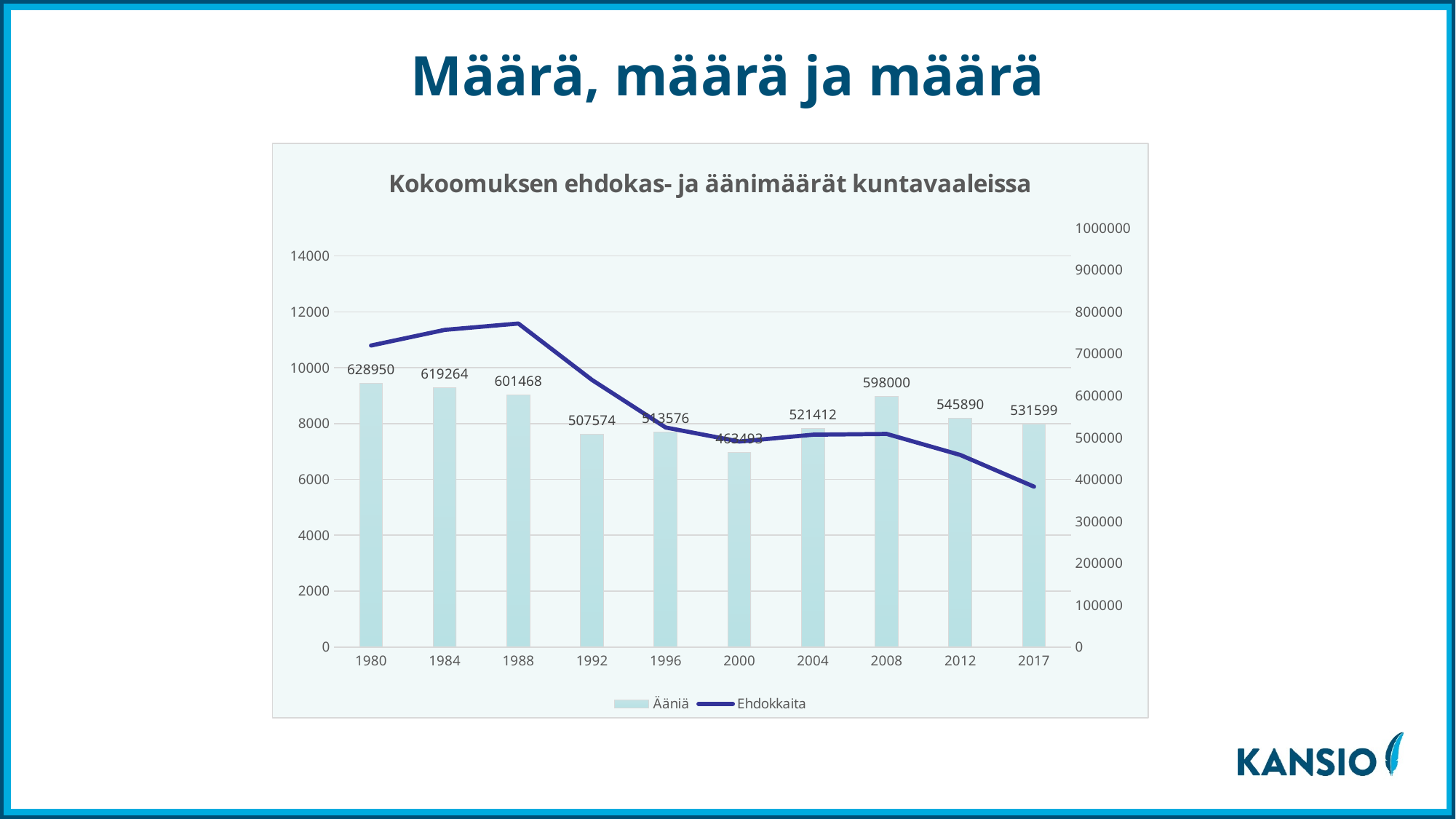
What is the value of Ääniä for 1980? 628950 Which year has the highest Ääniä value? 1980 What is the value of Ääniä for 2017? 531599 Which year has the lowest Ääniä bar? 2000 How many series does the legend list? 2 Is the Ehdokkaita value for 1988 greater or less than 10000? greater What is the difference between the Ääniä values for 1980 and 1984? 9686 Does the Ehdokkaita line rise or fall from 1988 to 2017? fall How many years are shown on the x axis? 10 What is the value of Ääniä for 2008? 598000 Is the Ehdokkaita value for 2017 greater or less than 8000? less Which year has the larger Ääniä value, 2004 or 2012? 2012